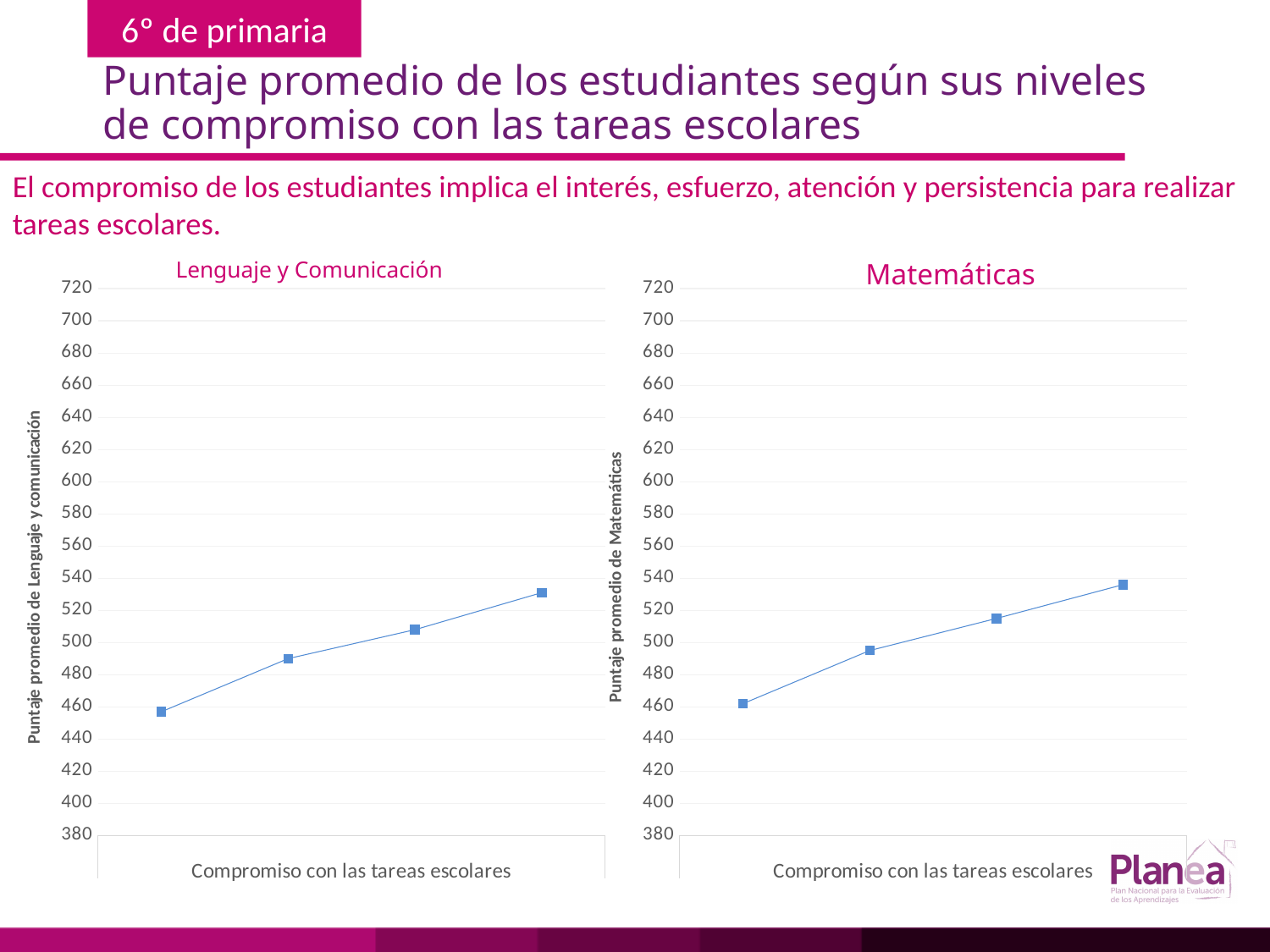
How many data points are plotted in the Matemáticas chart? 4 In the Matemáticas chart, is the value of the leftmost point greater or less than 480? less In the Lenguaje y Comunicación chart, is the value of the leftmost point greater or less than 480? less What is the y-axis title of the Lenguaje y Comunicación chart? Puntaje promedio de Lenguaje y comunicación In the Matemáticas chart, do the values rise or fall from left to right along the x axis? rise In the Matemáticas chart, is the value of the third point from the left greater or less than 500? greater What is the x-axis title of the Matemáticas chart? Compromiso con las tareas escolares What kind of chart is the Lenguaje y Comunicación chart? line chart In the Lenguaje y Comunicación chart, which point has the highest value, the leftmost or the rightmost? the rightmost In the Lenguaje y Comunicación chart, do the values rise or fall from left to right along the x axis? rise